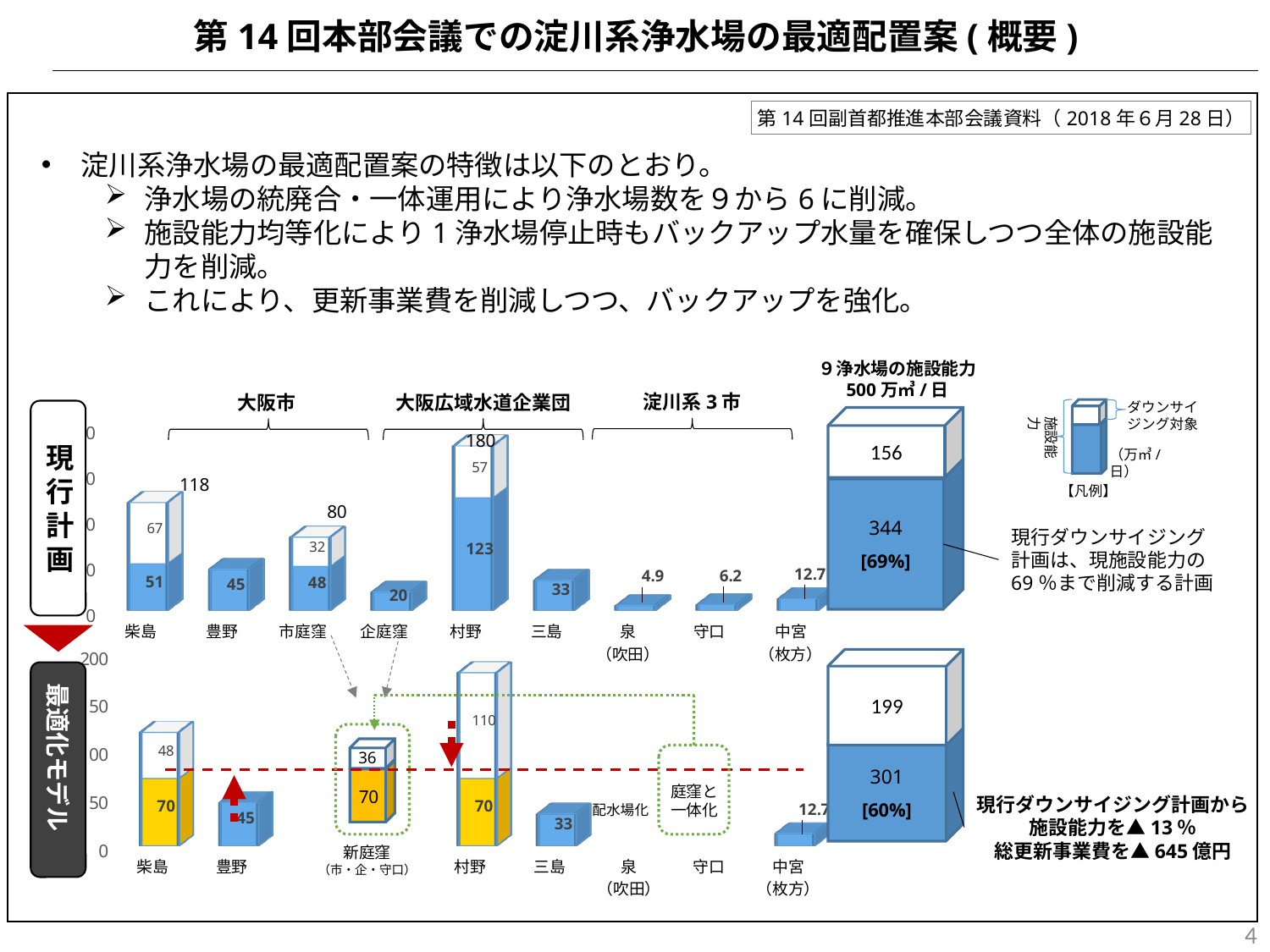
In the top chart (現行計画), what is the value labelled for 守口? 6.2 In the bottom chart (最適化モデル), what is the downsizing-target portion labelled on the 村野 bar? 110 In the top chart (現行計画), which plant has the highest total capacity? 村野 In the top chart (現行計画), what is the blue (retained) portion of the 村野 bar? 123 In the top chart (現行計画), what is the total capacity labelled above the 柴島 bar? 118 In the top chart (現行計画), what is the difference between the total capacity of 村野 (180) and 柴島 (118)? 62 In the top chart (現行計画), which plant has the lowest capacity? 泉（吹田） In the bottom chart (最適化モデル), what is the yellow (retained) value for 新庭窪? 70 In the top chart (現行計画), what percentage is shown for the 344 portion of the 9-plant total? 69% In the top chart (現行計画), what is the value labelled for 豊野? 45 In the bottom chart (最適化モデル), what is the total of the large summary bar (301 + 199)? 500 In the bottom chart (最適化モデル), which is larger: the value for 三島 or the value for 中宮（枚方）? 三島